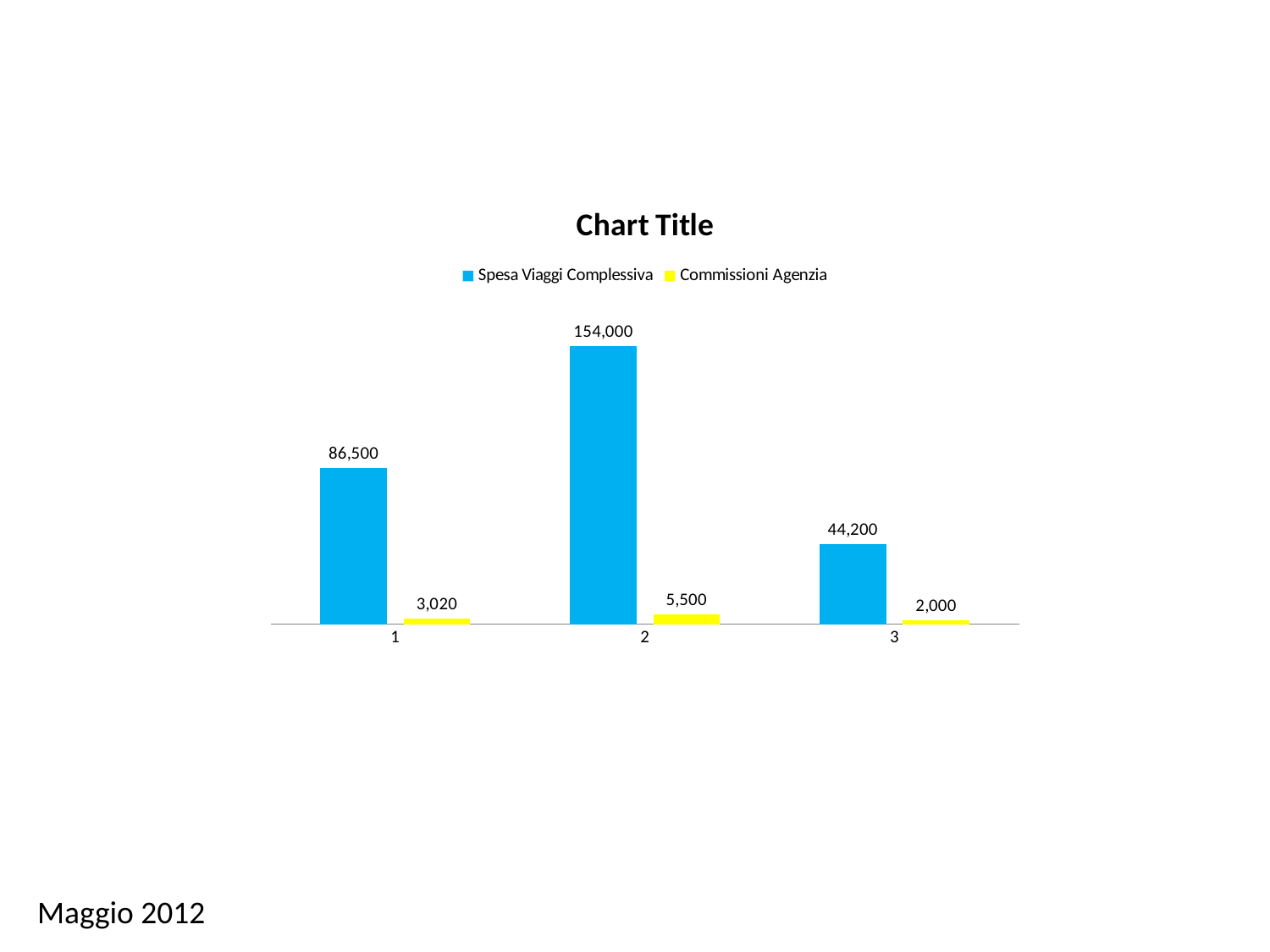
What is the value of Commissioni Agenzia for category 3? 2,000 How many categories are shown on the x axis? 3 How many series does the legend list? 2 What is the value of Spesa Viaggi Complessiva for category 2? 154,000 What is the difference between Commissioni Agenzia for category 2 and category 3? 3,500 What is the difference between Spesa Viaggi Complessiva for category 2 and category 1? 67,500 What is the value of Spesa Viaggi Complessiva for category 3? 44,200 What kind of chart is shown on the slide? Bar chart Which category has the lowest Commissioni Agenzia? 3 Which is larger: Spesa Viaggi Complessiva for category 1 or for category 3? Category 1 What is the value of Commissioni Agenzia for category 1? 3,020 Which category has the highest Spesa Viaggi Complessiva? 2